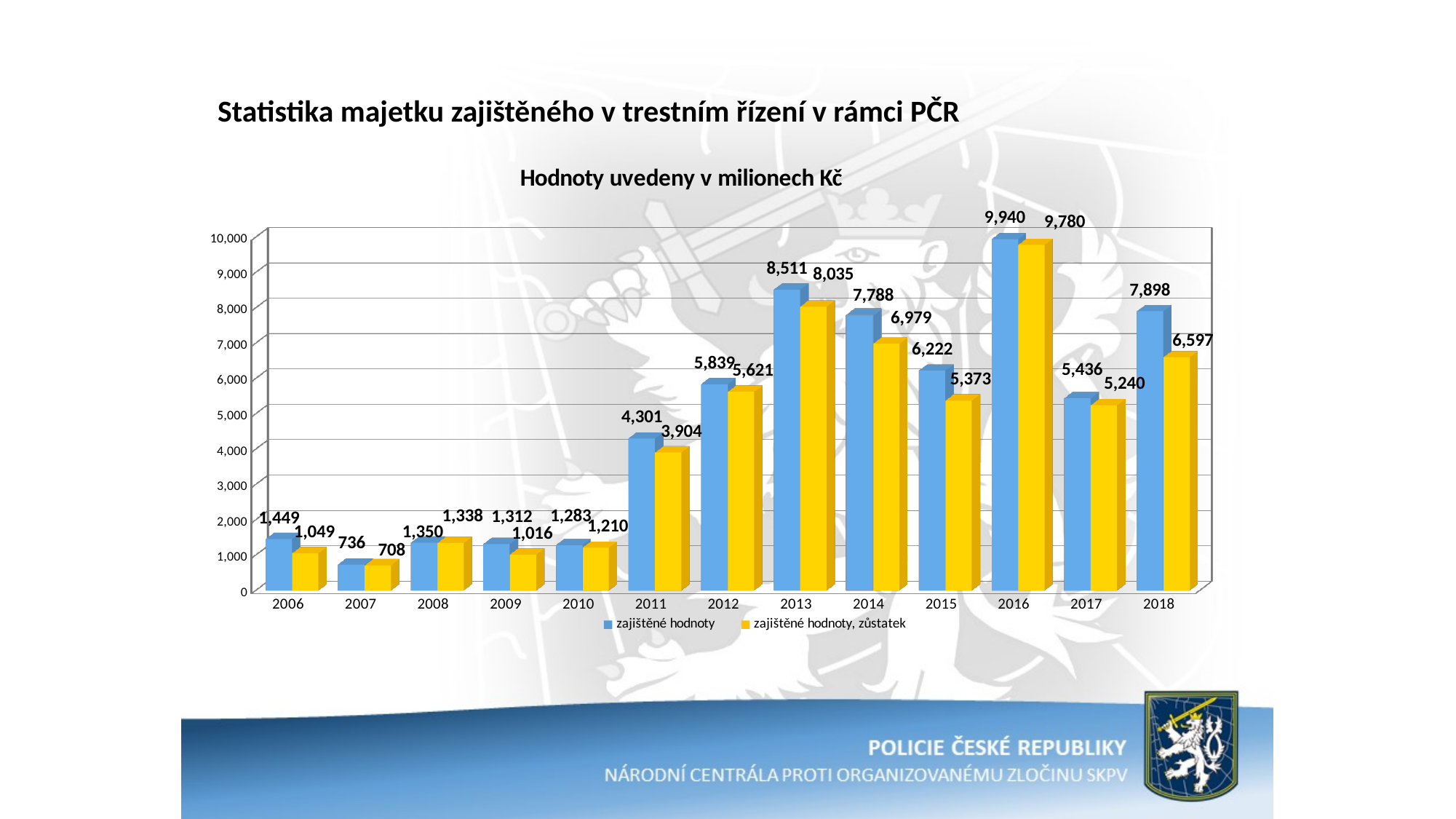
How many series does the chart's legend list? 2 What is the title of the chart? Hodnoty uvedeny v milionech Kč Which year has the lowest value of "zajištěné hodnoty, zůstatek"? 2007 What is the value of "zajištěné hodnoty" for 2016? 9,940 How many years are shown on the x axis of the chart? 13 What is the value of "zajištěné hodnoty, zůstatek" for 2013? 8,035 What is the difference between "zajištěné hodnoty" and "zajištěné hodnoty, zůstatek" in 2018? 1,301 Is the value of "zajištěné hodnoty, zůstatek" for 2015 greater or less than 5,000? greater Which is larger: "zajištěné hodnoty" in 2014 or "zajištěné hodnoty" in 2018? 2018 What is the value of "zajištěné hodnoty" for 2007? 736 Which year has the highest value of "zajištěné hodnoty"? 2016 What kind of chart is shown on the slide? bar chart